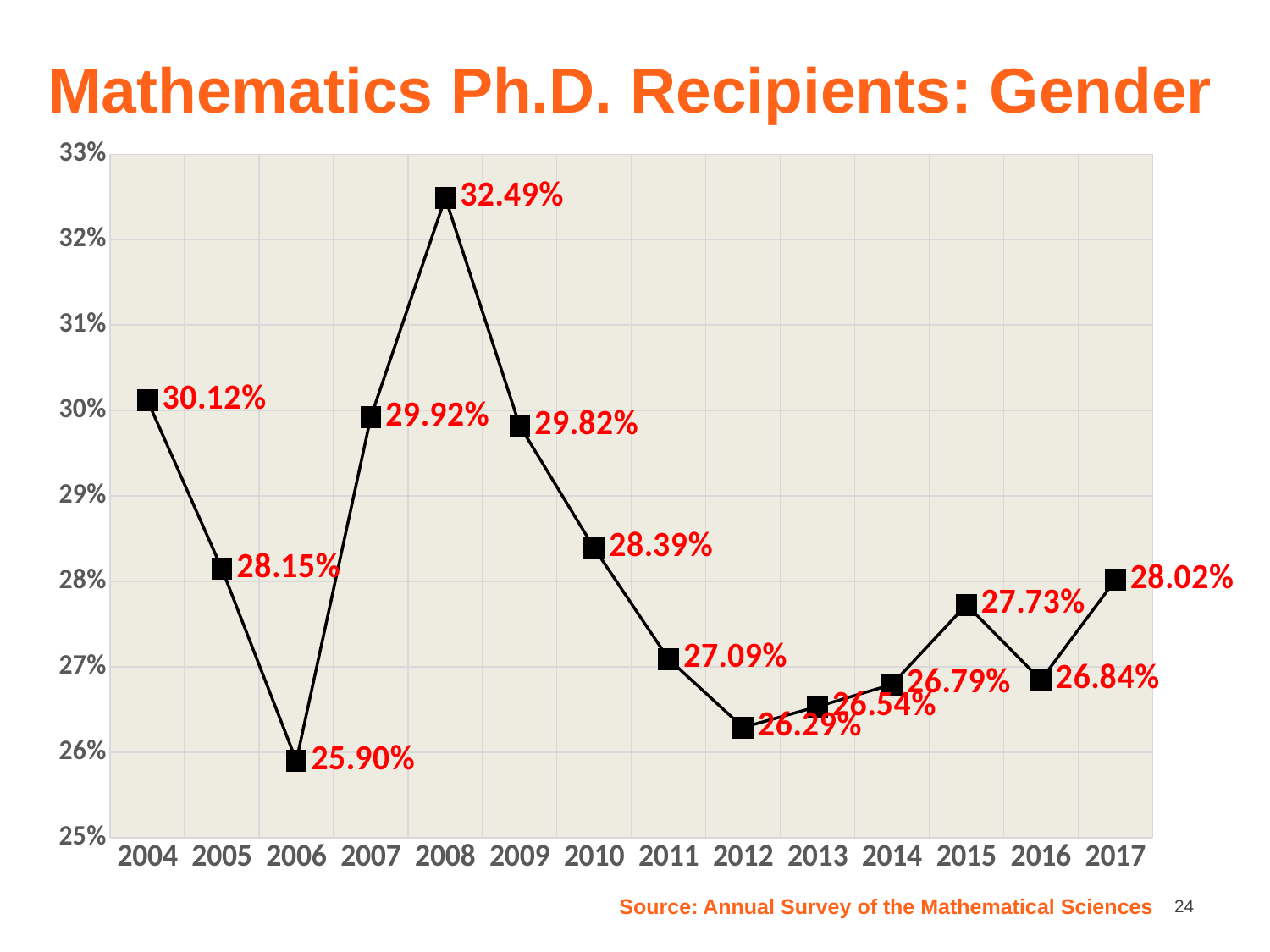
What is the value for 2008? 32.49% Which year has the larger value, 2004 or 2007? 2004 What is the value for 2006? 25.90% What is the title of the slide? Mathematics Ph.D. Recipients: Gender Is the value for 2015 greater or less than 27%? greater What is the value for 2017? 28.02% What is the difference between the values for 2008 and 2006? 6.59 percentage points Which year has the highest value? 2008 Do the values rise or fall from 2009 to 2012? fall How many years are plotted on the chart? 14 What kind of chart is shown on the slide? line chart Which year has the lowest value? 2006